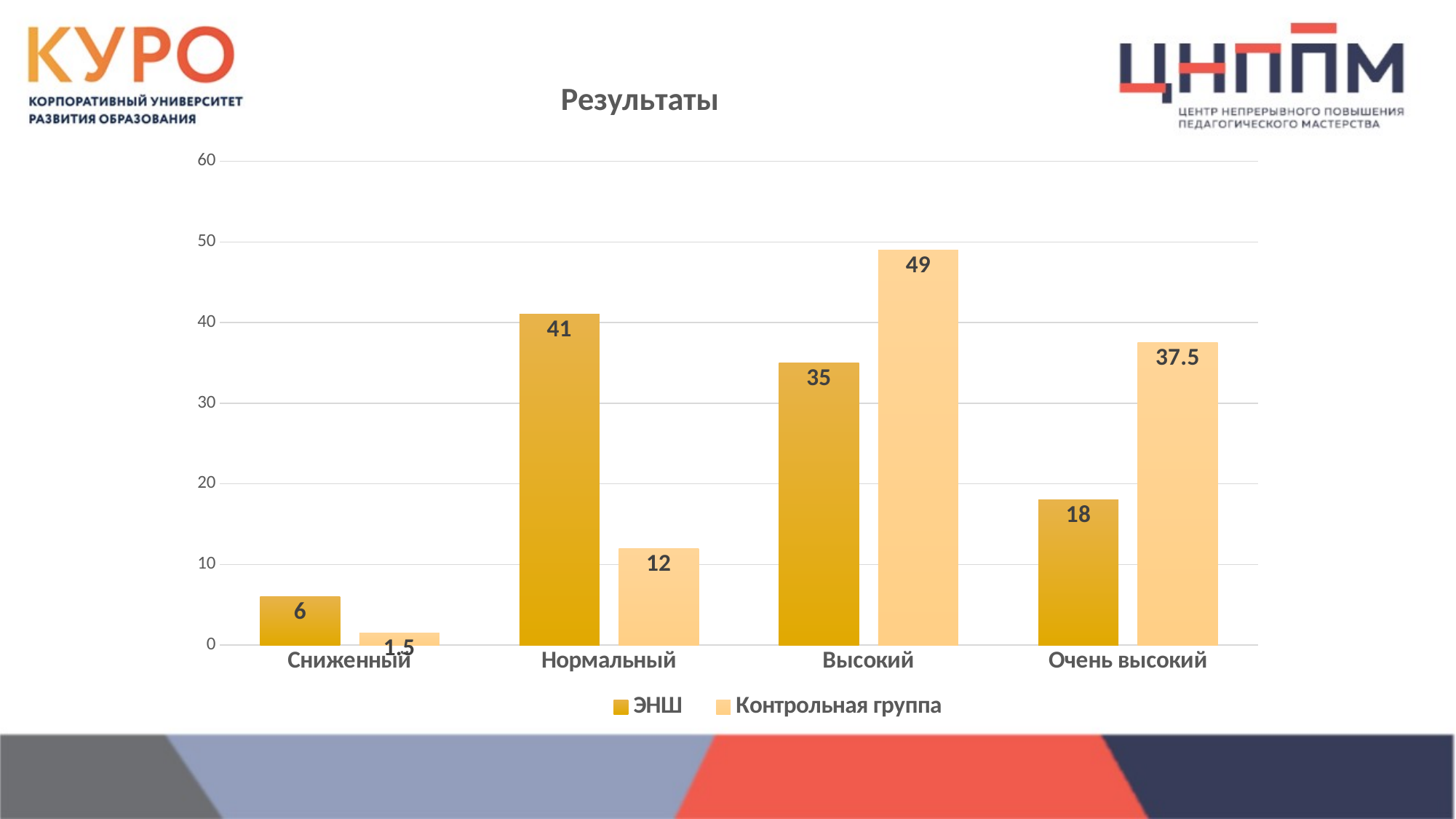
How many categories are shown on the x axis? 4 What is the value for Контрольная группа in the Очень высокий category? 37.5 What is the title of the chart? Результаты In the Нормальный category, which series has the larger value, ЭНШ or Контрольная группа? ЭНШ How many series does the legend list? 2 What is the value for ЭНШ in the Нормальный category? 41 Which category has the highest value for the ЭНШ series? Нормальный What is the difference between the Контрольная группа and ЭНШ values in the Высокий category? 14 What kind of chart is shown on the slide? Bar chart Which category has the lowest value for the Контрольная группа series? Сниженный What is the value for ЭНШ in the Сниженный category? 6 What is the value for Контрольная группа in the Высокий category? 49